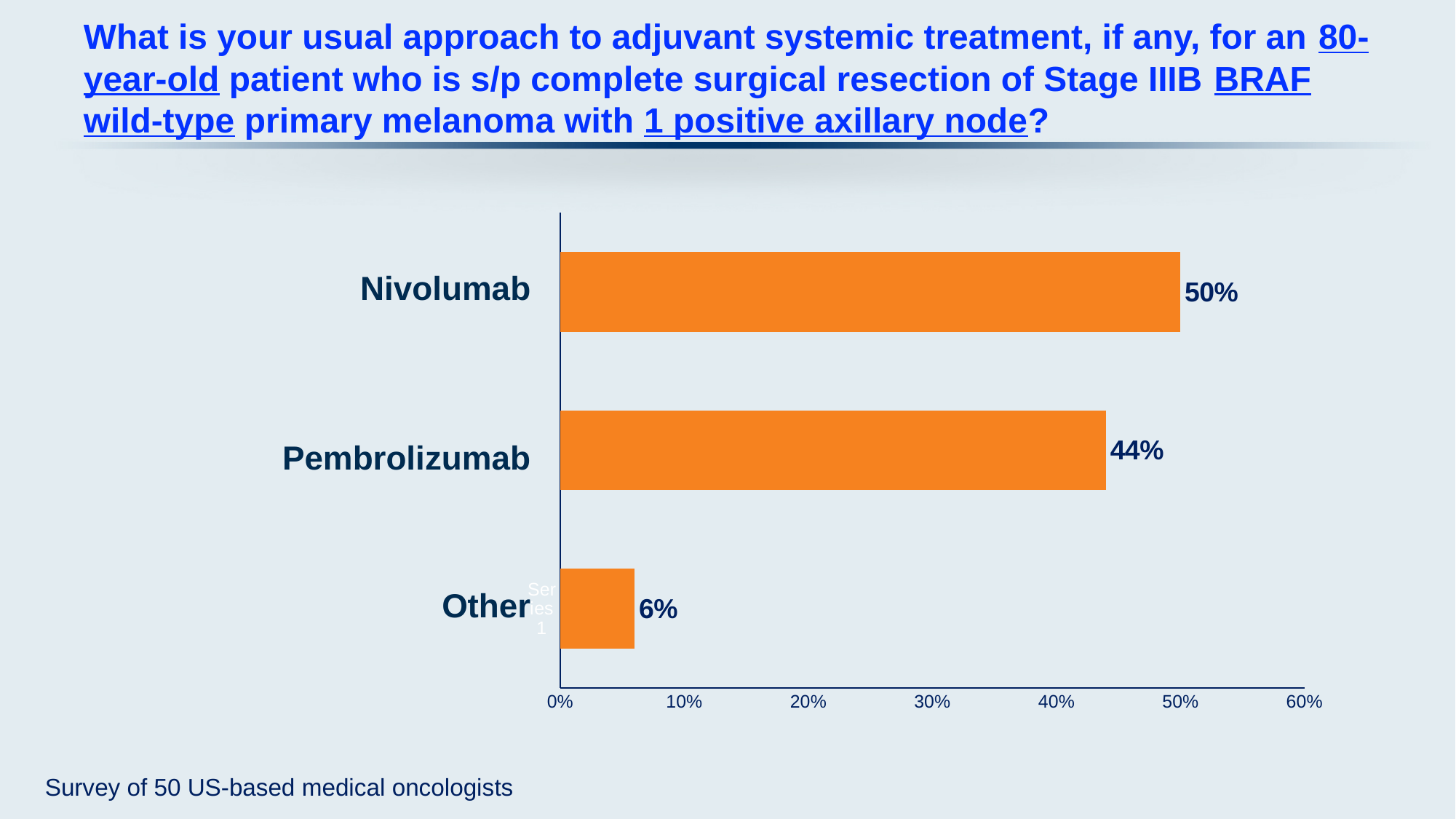
Which category has the lowest value? Other Which is larger, the value for Nivolumab or the value for Pembrolizumab? Nivolumab What is the difference between the values for Nivolumab and Pembrolizumab? 6% How many medical oncologists were surveyed, according to the note at the bottom of the slide? 50 Which category has the highest value? Nivolumab Is the value for Pembrolizumab greater or less than 40%? greater What kind of chart is shown on the slide? bar chart How many categories are shown in the chart? 3 What is the difference between the values for Pembrolizumab and Other? 38% What percentage of respondents chose Nivolumab? 50% What percentage of respondents chose Other? 6% What percentage of respondents chose Pembrolizumab? 44%